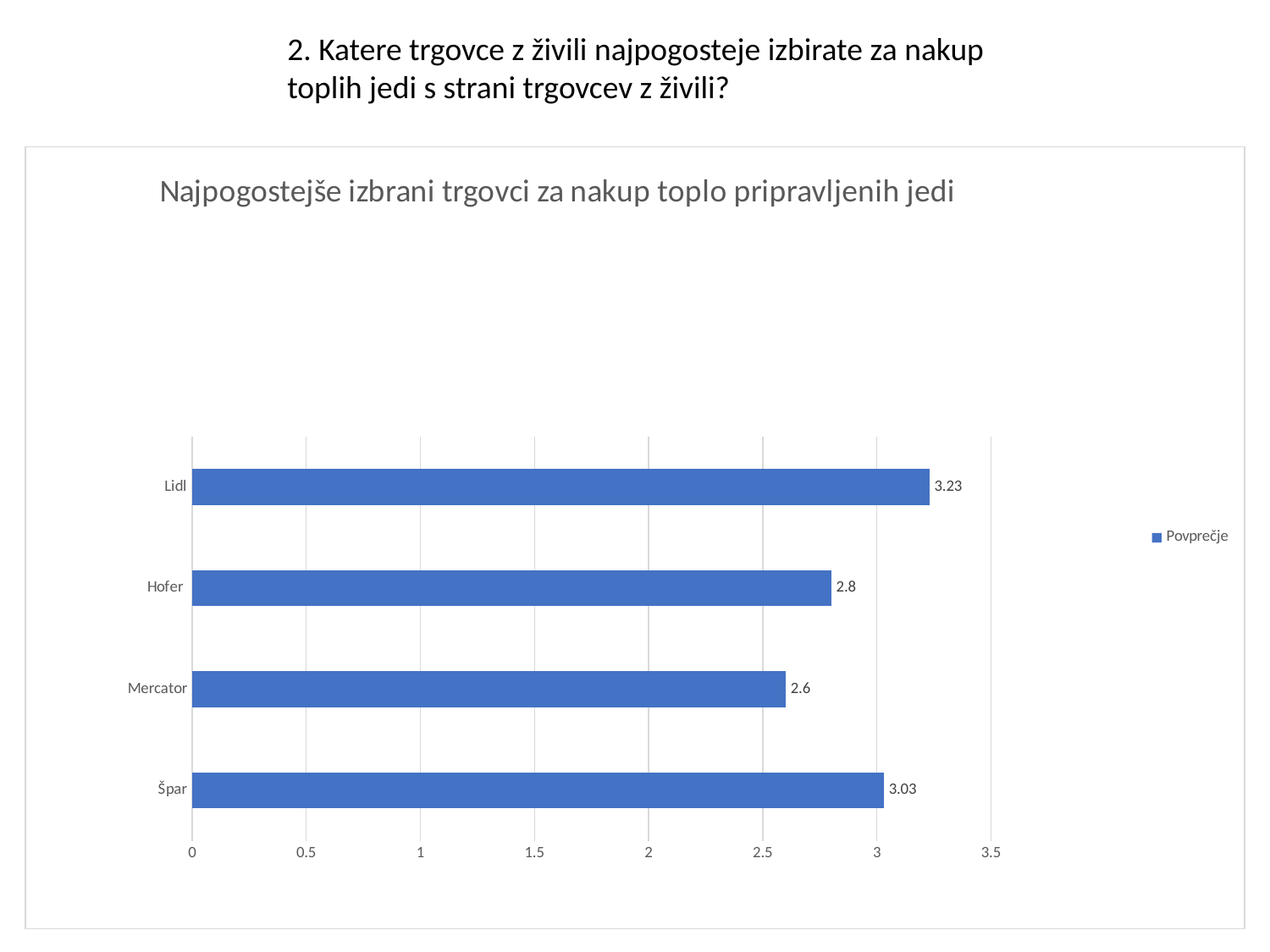
What kind of chart is shown on the slide? Bar chart Which retailer has the highest value? Lidl What is the value for Lidl? 3.23 What series name does the legend show? Povprečje What is the difference between the values for Lidl and Špar? 0.2 Which is larger, the value for Špar or the value for Hofer? Špar What is the value for Špar? 3.03 Which retailer has the lowest value? Mercator What is the value for Hofer? 2.8 What is the value for Mercator? 2.6 What is the difference between the values for Hofer and Mercator? 0.2 How many retailers are shown in the chart? 4